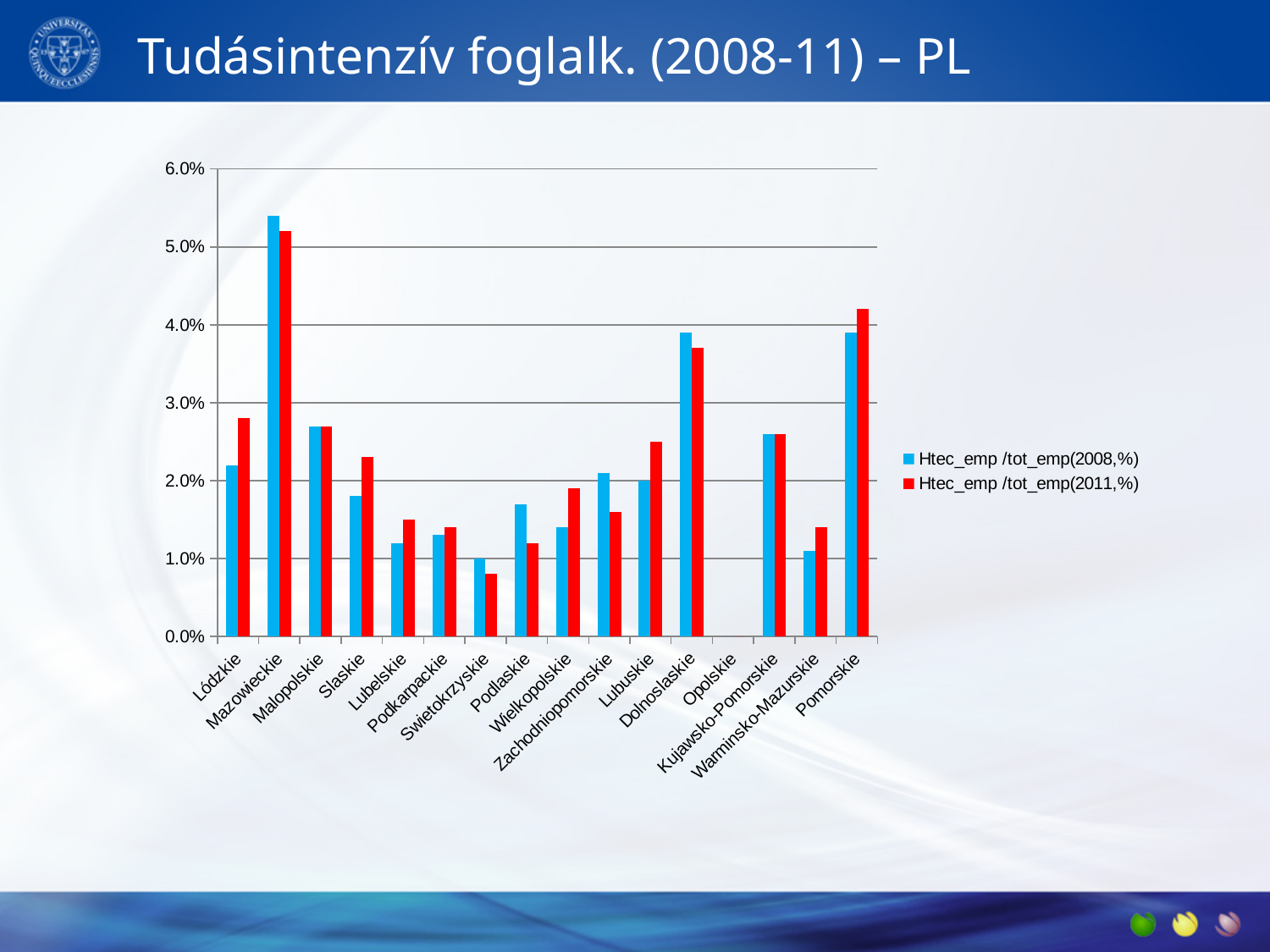
Is the Htec_emp /tot_emp(2011,%) value for Pomorskie greater or less than 4.0%? greater What kind of chart is shown on the slide? bar chart Which region has the highest value for Htec_emp /tot_emp(2011,%)? Mazowieckie Is the Htec_emp /tot_emp(2008,%) value for Mazowieckie greater or less than 5.0%? greater For Lódzkie, which series has the larger value: Htec_emp /tot_emp(2008,%) or Htec_emp /tot_emp(2011,%)? Htec_emp /tot_emp(2011,%) Which colour represents the Htec_emp /tot_emp(2011,%) series in the legend? red Which region has the highest value for Htec_emp /tot_emp(2008,%)? Mazowieckie Is the Htec_emp /tot_emp(2011,%) value for Lubuskie greater or less than 2.0%? greater For Podlaskie, which series has the larger value: Htec_emp /tot_emp(2008,%) or Htec_emp /tot_emp(2011,%)? Htec_emp /tot_emp(2008,%) How many series does the legend list? 2 How many regions are listed along the x axis? 16